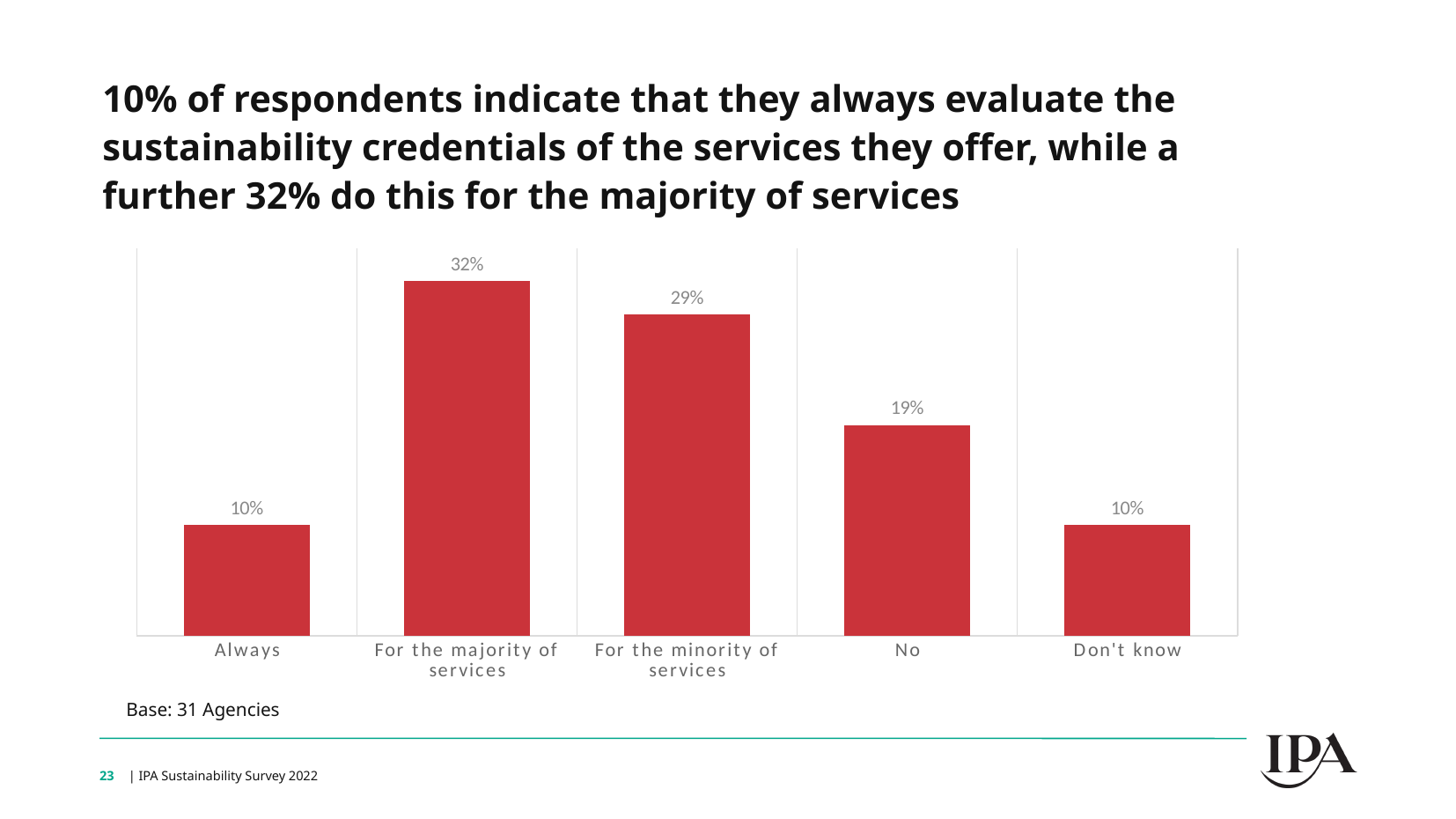
What is the value for "For the minority of services"? 29% What percentage of respondents answered "For the majority of services"? 32% What percentage of respondents answered "Don't know"? 10% How many categories are shown on the x axis? 5 Which is larger, the value for "No" or the value for "Don't know"? No What is the difference between the values for "For the majority of services" and "For the minority of services"? 3% What is the difference between the values for "No" and "Always"? 9% Which category has the highest value? For the majority of services What colour are the bars in the chart? Red What type of chart is shown on the slide? Bar chart What is the base (number of agencies) stated below the chart? 31 Agencies What is the value shown for the "No" category? 19%